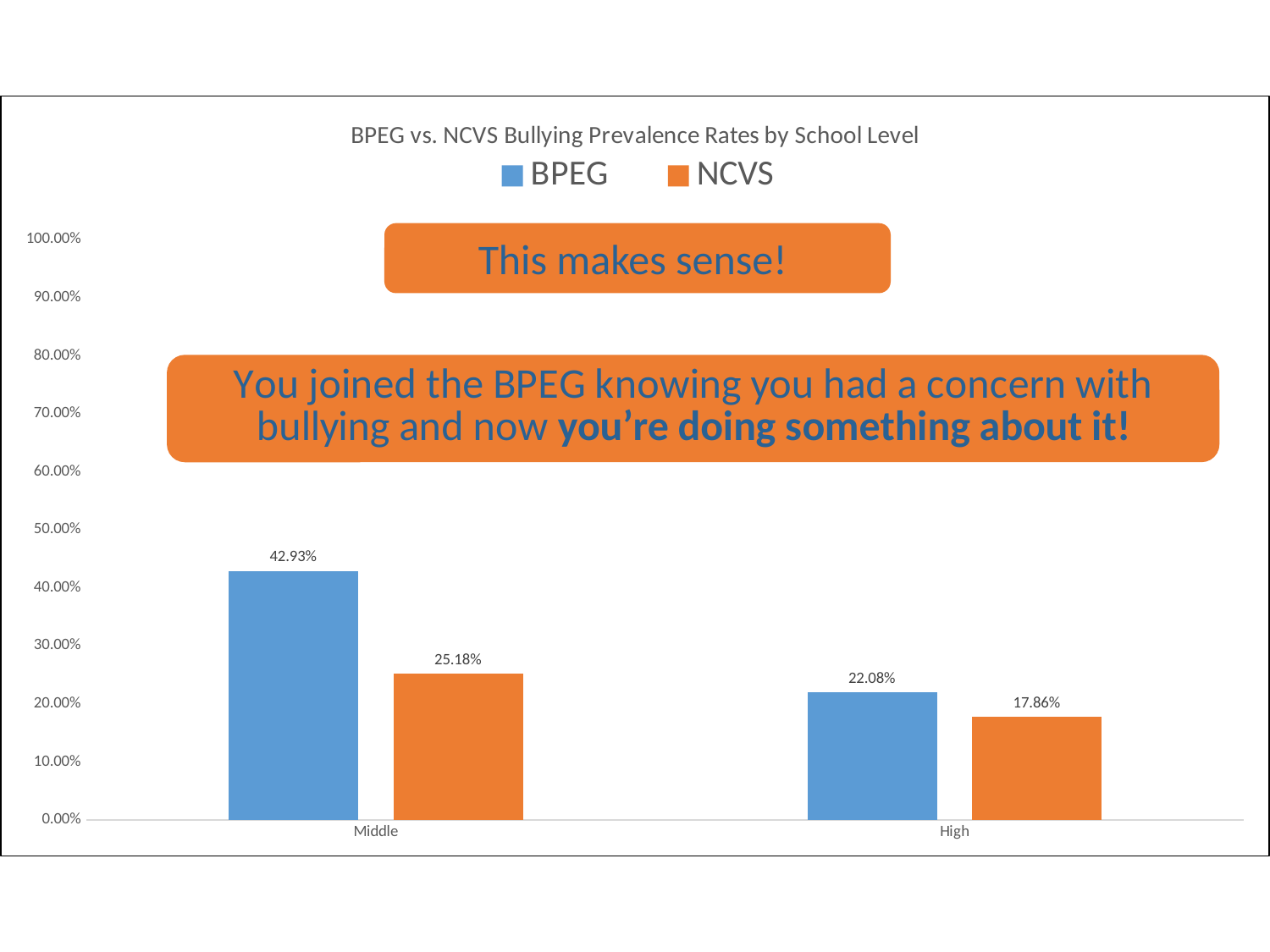
How many school levels are shown on the x axis? 2 What is the difference between the BPEG values for Middle and High? 20.85% What is the NCVS value for High? 17.86% What is the NCVS value for Middle? 25.18% Which bar has the lowest value on the chart? NCVS for High Is the BPEG value for Middle greater or less than 40.00%? greater What is the difference between the BPEG and NCVS values for Middle? 17.75% How many series does the legend list? 2 Which is larger for High, the BPEG value or the NCVS value? BPEG Which school level has the highest BPEG value? Middle What is the BPEG value for Middle? 42.93% What kind of chart is shown on the slide? Bar chart